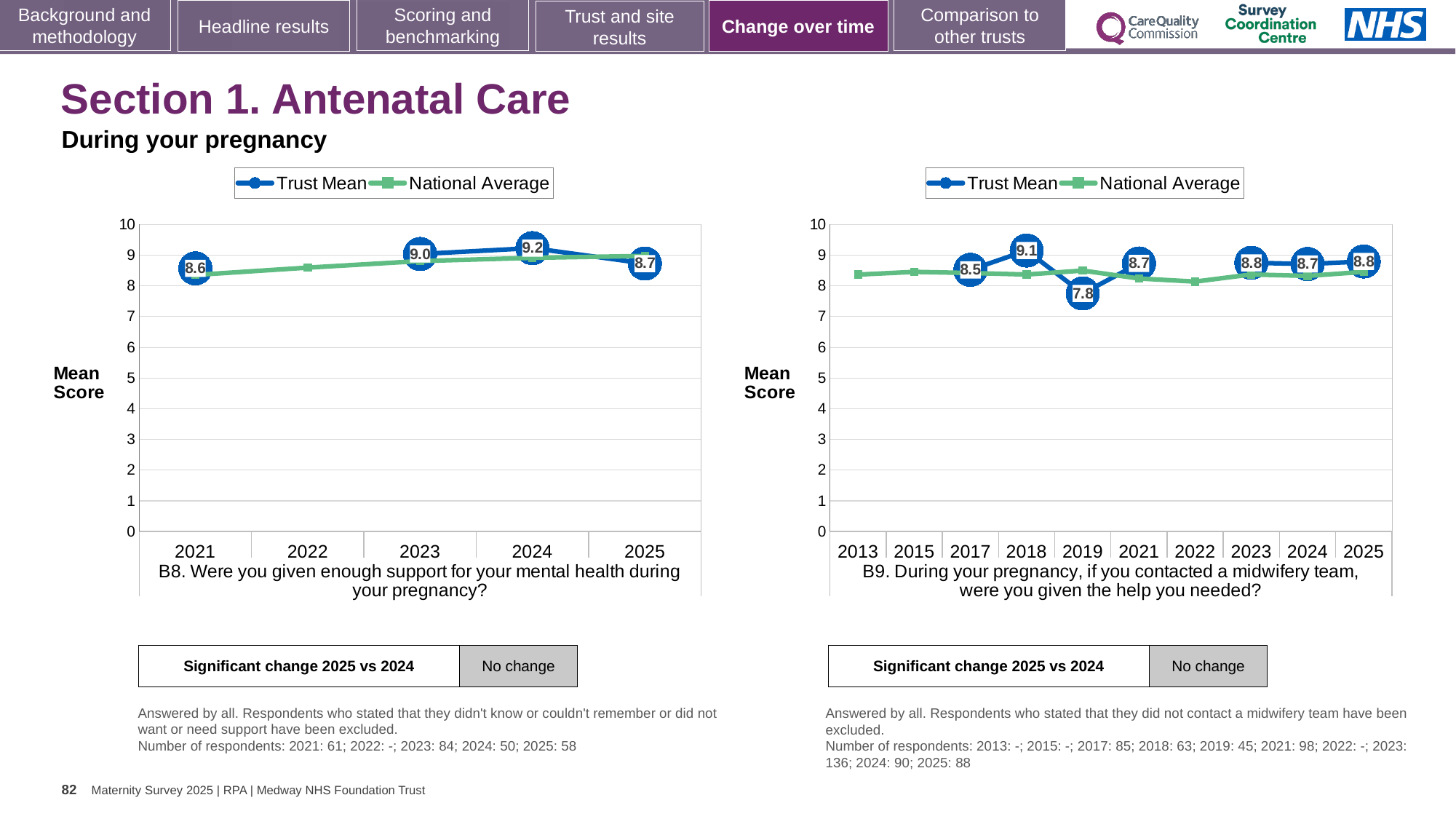
In the B9 chart on the right, how many years are shown on the x axis? 10 In the B8 chart on the left, what is the Trust Mean for 2024? 9.2 In the B9 chart on the right, which year has the highest Trust Mean? 2018 In the B8 chart on the left, what is the difference between the Trust Mean in 2024 and in 2025? 0.5 In the B8 chart on the left, how many series does the legend list? 2 In the B9 chart on the right, is the Trust Mean higher in 2018 or in 2017? 2018 What type of chart is the B8 chart on the left? Line chart In the B8 chart on the left, what is the Trust Mean for 2021? 8.6 In the B9 chart on the right, what is the difference between the Trust Mean in 2018 and in 2019? 1.3 In the B9 chart on the right, which year has the lowest Trust Mean? 2019 In the B9 chart on the right, what is the Trust Mean for 2019? 7.8 In the B8 chart on the left, which year has the highest Trust Mean? 2024